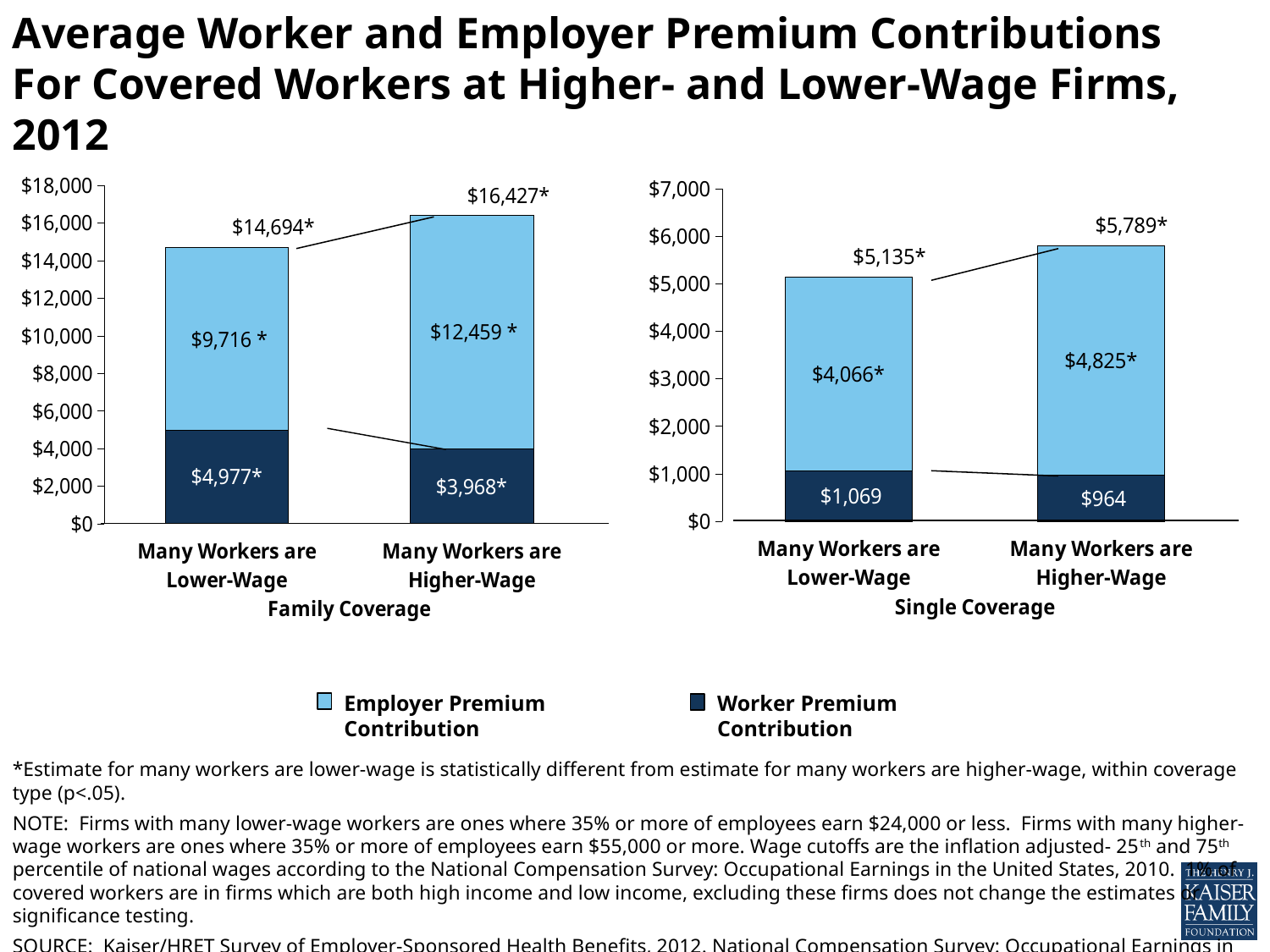
In the Family Coverage chart, what is the Worker Premium Contribution for firms where many workers are higher-wage? $3,968 In the Single Coverage chart, what is the difference in Employer Premium Contribution between higher-wage and lower-wage firms? $759 In the Family Coverage chart, which category has the larger total premium, lower-wage or higher-wage firms? Many Workers are Higher-Wage In the Single Coverage chart, what is the Worker Premium Contribution for firms where many workers are lower-wage? $1,069 In the Single Coverage chart, what is the total premium for firms where many workers are lower-wage? $5,135 In the Family Coverage chart, what is the total premium for firms where many workers are higher-wage? $16,427 In the Family Coverage chart, how much larger is the Worker Premium Contribution at lower-wage firms than at higher-wage firms? $1,009 How many series does the legend list? 2 What kind of chart is the Single Coverage chart? Stacked bar chart In the Single Coverage chart, what is the Employer Premium Contribution for firms where many workers are higher-wage? $4,825 How many categories are shown on the x axis of the Single Coverage chart? 2 In the Family Coverage chart, what is the Employer Premium Contribution for firms where many workers are lower-wage? $9,716